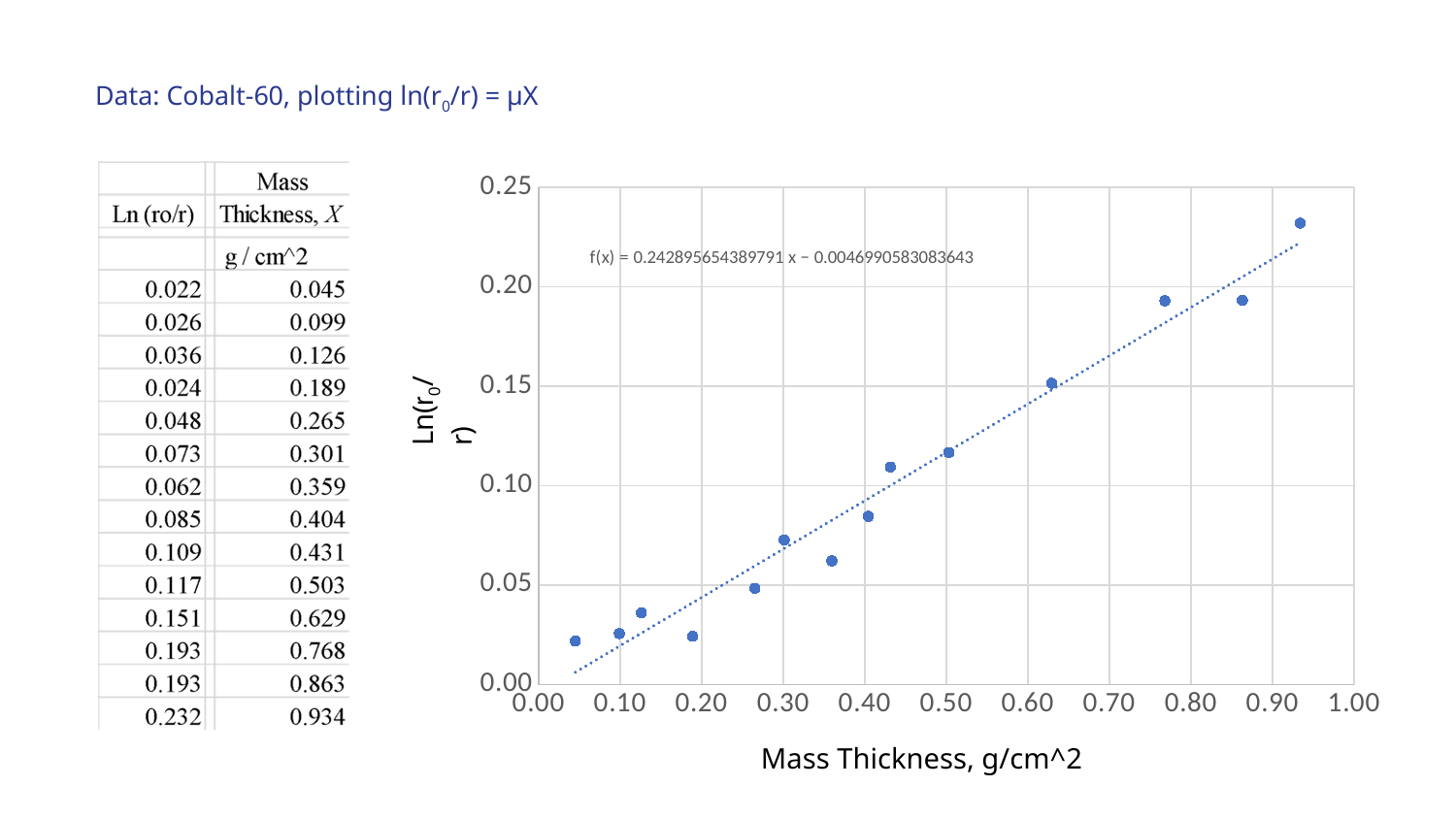
What is the highest plotted value of Ln(r0/r)? 0.232 Is the Ln(r0/r) value at mass thickness 0.301 greater or less than 0.10? less What is the value of Ln(r0/r) at a mass thickness of 0.503 g/cm^2? 0.117 What is the label of the x axis of the chart? Mass Thickness, g/cm^2 What is the difference between the Ln(r0/r) values at mass thickness 0.934 and 0.863? 0.039 What is the value of Ln(r0/r) at a mass thickness of 0.934 g/cm^2? 0.232 Do the Ln(r0/r) values generally rise or fall as mass thickness increases? Rise How many data points are plotted in the chart? 14 At which mass thickness is Ln(r0/r) highest? 0.934 What kind of chart is shown on the slide? Scatter chart Which has the larger Ln(r0/r) value: mass thickness 0.431 or 0.359? 0.431 Is the Ln(r0/r) value at mass thickness 0.768 greater or less than 0.15? greater